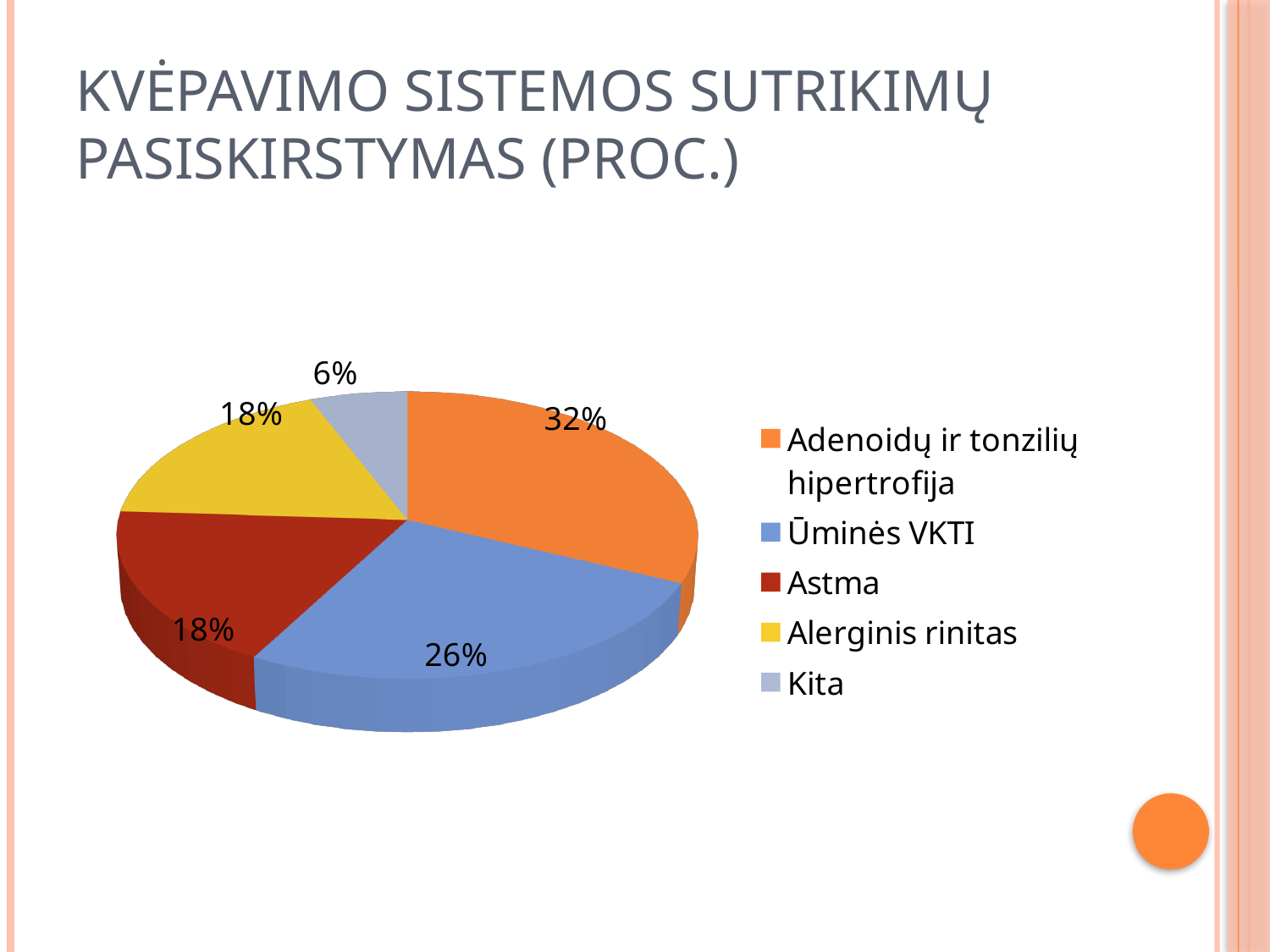
What type of chart is shown on the slide? Pie chart What is the combined share of Astma and Alerginis rinitas? 36% What percentage does the Adenoidų ir tonzilių hipertrofija slice represent? 32% Which is larger, the share for Ūminės VKTI or the share for Alerginis rinitas? Ūminės VKTI Which category has the smallest share of the pie? Kita What percentage does the Kita slice represent? 6% What is the difference in percentage points between Adenoidų ir tonzilių hipertrofija and Ūminės VKTI? 6 Which category has the largest share of the pie? Adenoidų ir tonzilių hipertrofija What colour is the Alerginis rinitas slice? Yellow How many categories are shown in the pie chart? 5 What percentage does the Ūminės VKTI slice represent? 26% What percentage does the Astma slice represent? 18%